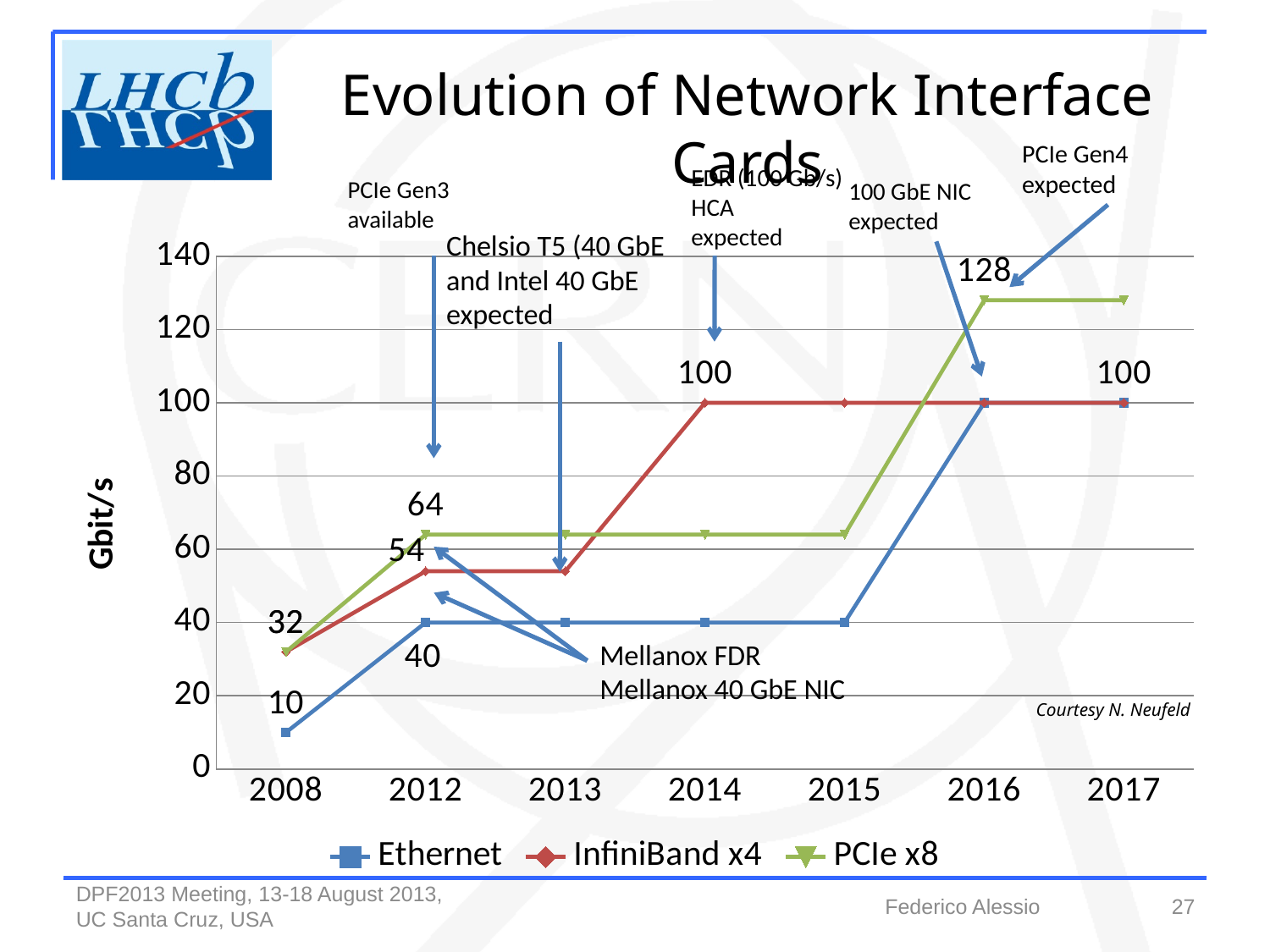
What is the InfiniBand x4 value in 2012? 54 How many series does the legend list? 3 Is the Ethernet value in 2015 greater or less than 60? less What is the InfiniBand x4 value in 2014? 100 How many years are shown on the x axis? 7 What is the Ethernet value in 2008? 10 What is the PCIe x8 value in 2012? 64 What is the label on the y axis? Gbit/s What kind of chart is shown on the slide? line chart What is the PCIe x8 value in 2016? 128 Which series has the highest value in 2017? PCIe x8 What is the difference between the PCIe x8 and InfiniBand x4 values in 2012? 10